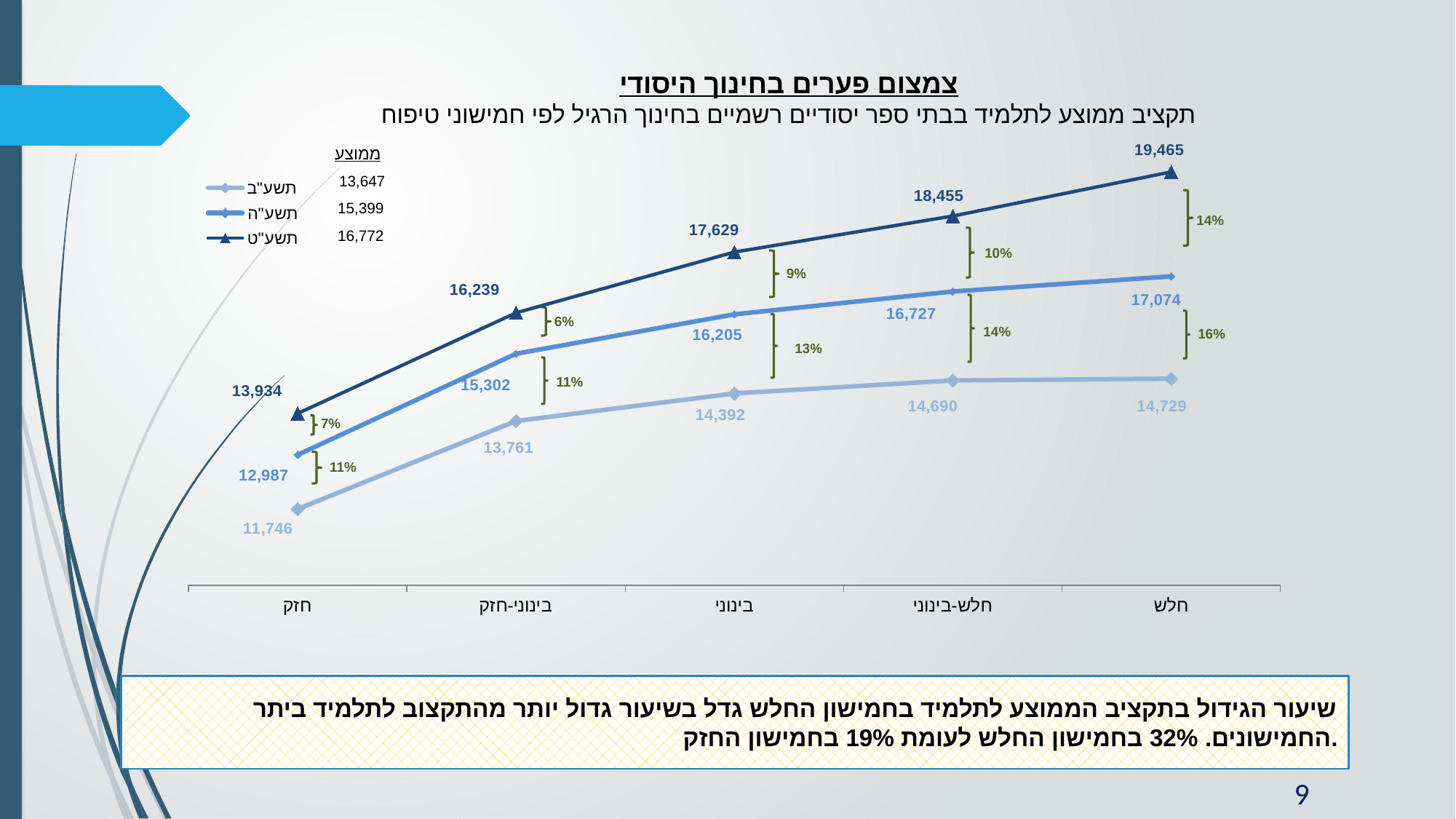
What percentage gap is labelled between the תשע"ט and תשע"ה lines in the חלש category? 14% What is the difference between the תשע"ט and תשע"ב values in the חלש category? 4,736 Which category has the lowest value for the תשע"ב series? חזק Which is larger: the תשע"ה value for חלש-בינוני or the תשע"ט value for בינוני-חזק? תשע"ה value for חלש-בינוני (16,727) What is the value for תשע"ב in the חזק category? 11,746 What is the average (ממוצע) shown in the legend for the תשע"ה series? 15,399 What is the value for תשע"ט in the חלש category? 19,465 How many categories are shown on the x axis? 5 What is the value for תשע"ה in the בינוני category? 16,205 Which category has the highest value for the תשע"ט series? חלש What type of chart is shown on the slide? line chart How many series does the legend list? 3